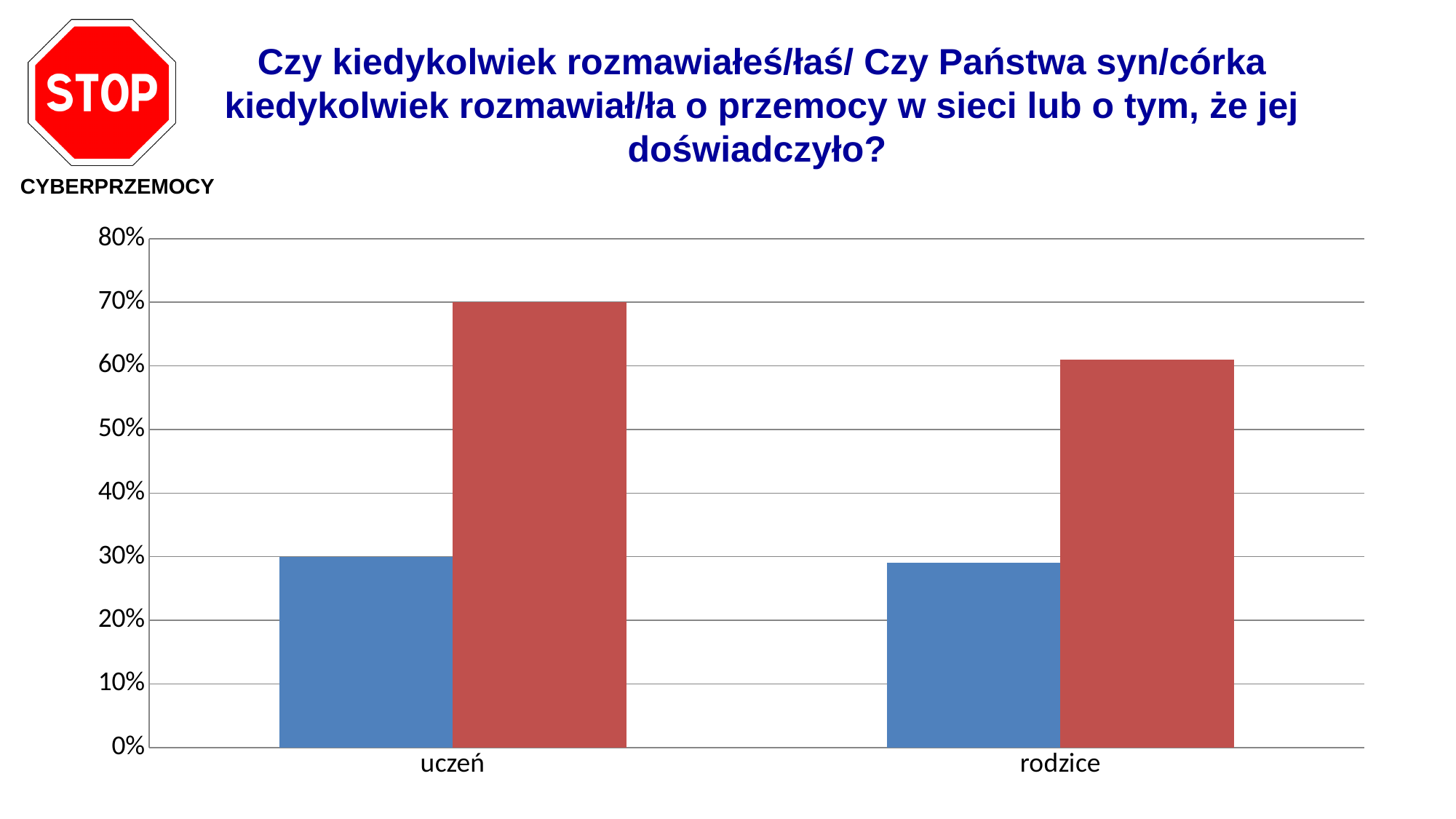
For rodzice, which bar is larger, the red one or the blue one? the red one How many categories are shown on the x axis of the chart? 2 Which bar is the tallest in the chart? the red bar for uczeń What is the value of the blue bar for uczeń? 30% What kind of chart is shown on the slide? bar chart What are the two categories on the x axis of the chart? uczeń and rodzice What is the difference between the red bar and the blue bar for uczeń? 40% Which red bar is taller, the one for uczeń or the one for rodzice? uczeń What is the highest value shown on the y axis of the chart? 80% Is the value of the blue bar for rodzice greater or less than 40%? less Is the value of the red bar for rodzice greater or less than 50%? greater What is the value of the red bar for uczeń? 70%